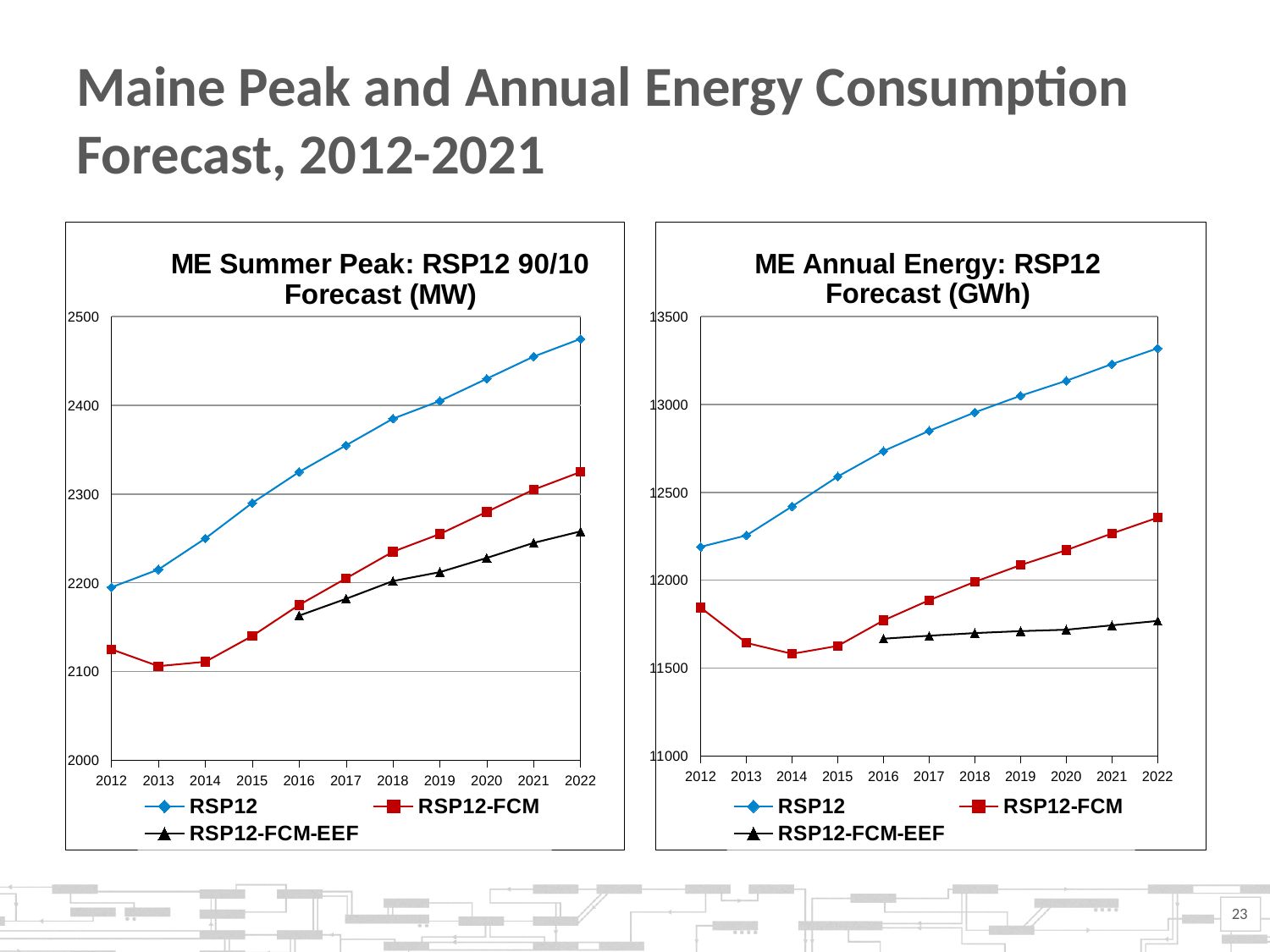
In the ME Annual Energy chart, does the RSP12 series rise or fall from 2012 to 2022? Rise In the ME Summer Peak chart, in which year does the RSP12-FCM-EEF series begin? 2016 What unit is given in the title of the chart on the right? GWh In the ME Summer Peak chart, which year has the highest RSP12 value? 2022 In the ME Annual Energy chart, is the RSP12-FCM-EEF value for 2022 greater or less than 12000? less How many series does the legend of the ME Annual Energy chart list? 3 How many years are shown on the x axis of the ME Summer Peak chart? 11 In the ME Summer Peak chart, is the RSP12-FCM value for 2022 greater or less than 2300? greater In the ME Annual Energy chart, which series is higher in 2022, RSP12 or RSP12-FCM-EEF? RSP12 In the ME Summer Peak chart, is the RSP12 value for 2022 greater or less than 2400? greater What type of chart is the ME Summer Peak chart on the left? Line chart